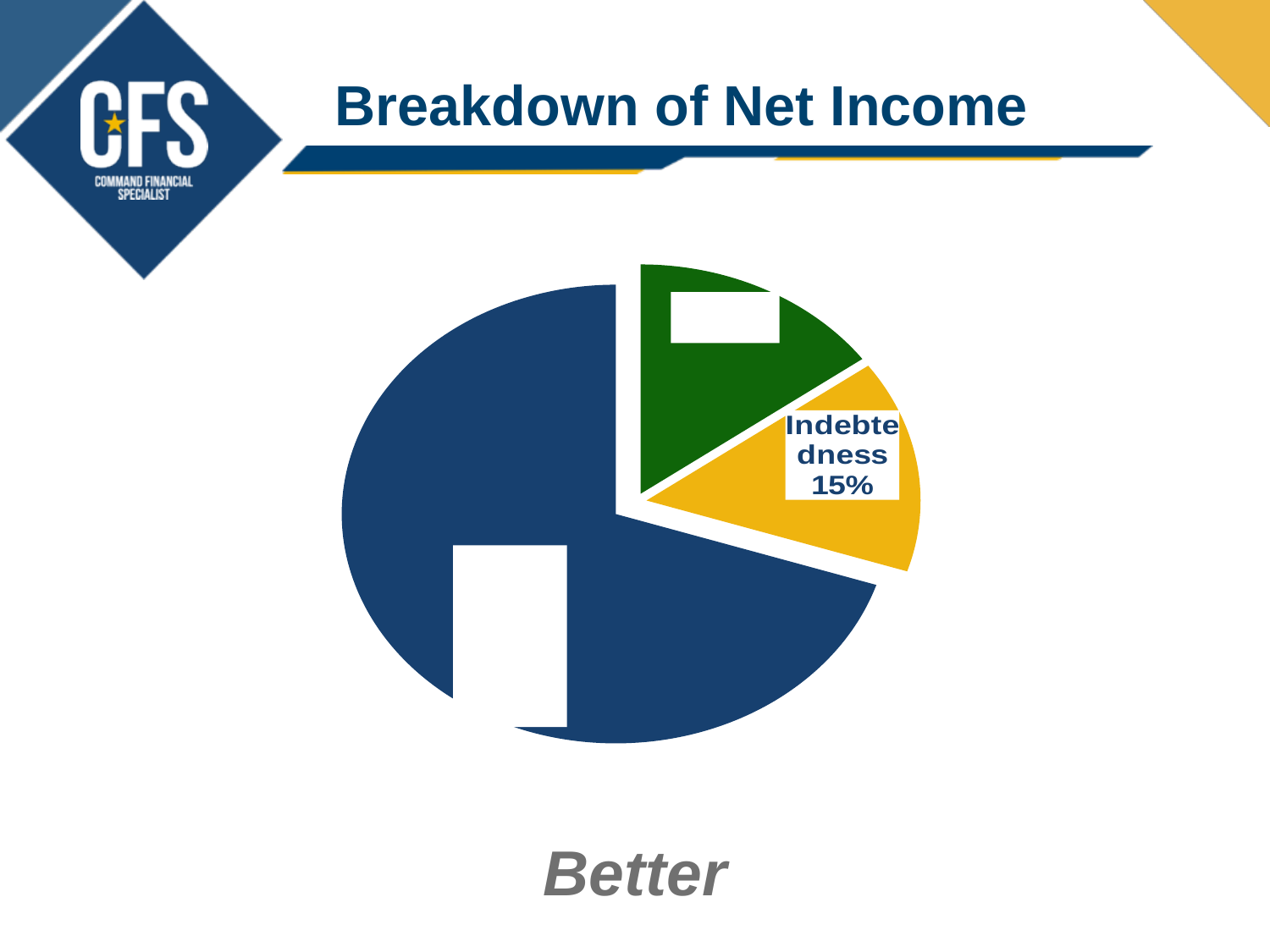
What is the title of the chart on the slide? Breakdown of Net Income Which is larger, the blue slice or the Indebtedness slice? the blue slice What share of net income does the Indebtedness slice represent? 15% How many slices does the pie chart have? 3 Is the large blue slice greater or less than 50% of the pie? greater What colour is the Indebtedness slice in the pie chart? yellow Is the Indebtedness slice greater or less than 25% of the pie? less What kind of chart is shown on the slide? pie chart